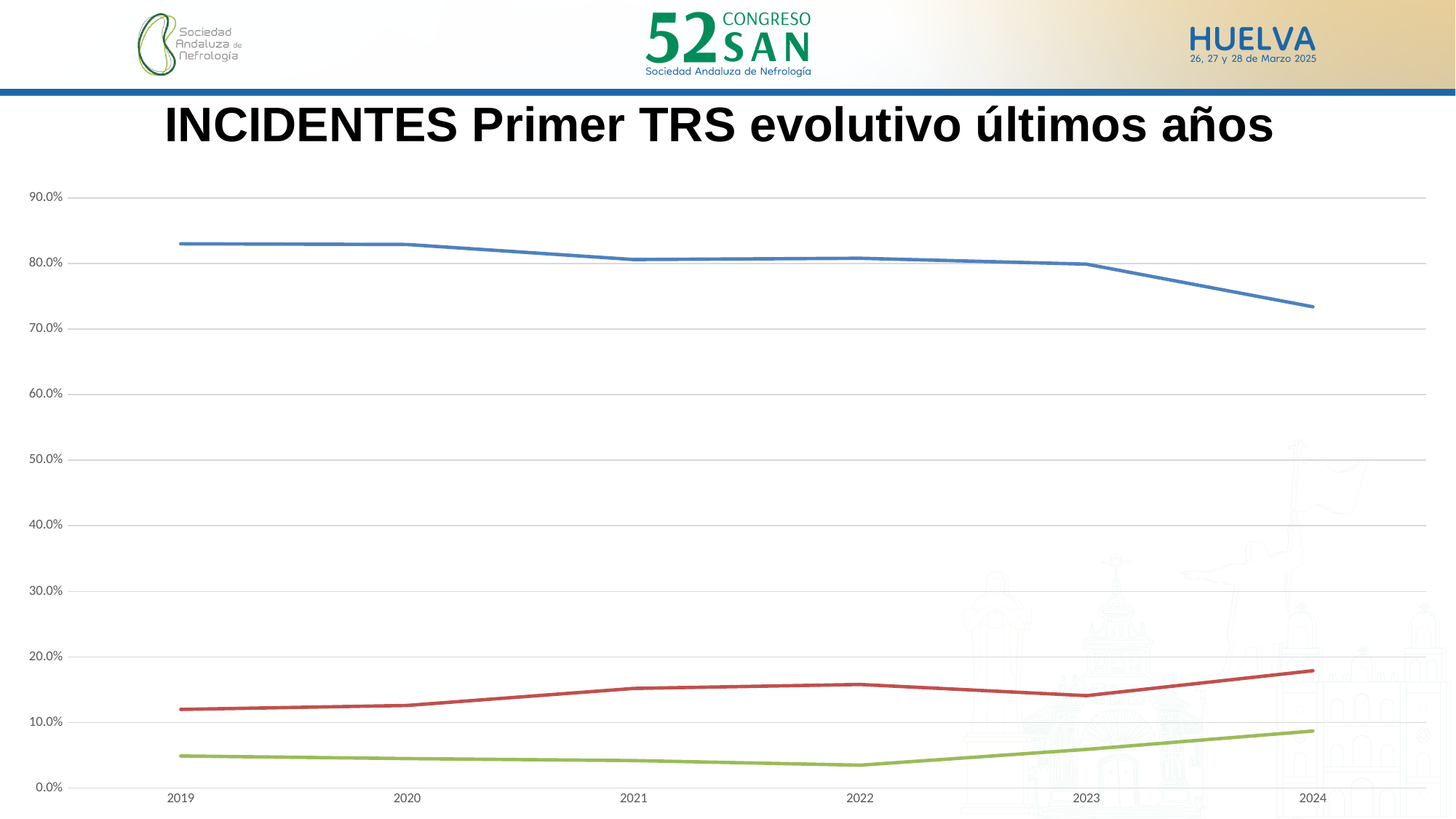
How many years are shown on the x axis of the chart? 6 In which year is the red line at its highest value? 2024 In which year is the green line at its highest value? 2024 Does the blue line rise or fall overall from 2019 to 2024? fall Is the value of the blue line in 2019 greater or less than 80.0%? greater What is the title of the chart on the slide? INCIDENTES Primer TRS evolutivo últimos años What kind of chart is shown on the slide? line chart In 2024, which line has the larger value, the red line or the green line? red line Is the value of the blue line in 2024 greater or less than 80.0%? less Does the red line rise or fall overall from 2019 to 2024? rise How many lines are plotted on the chart? 3 In which year is the blue line at its lowest value? 2024